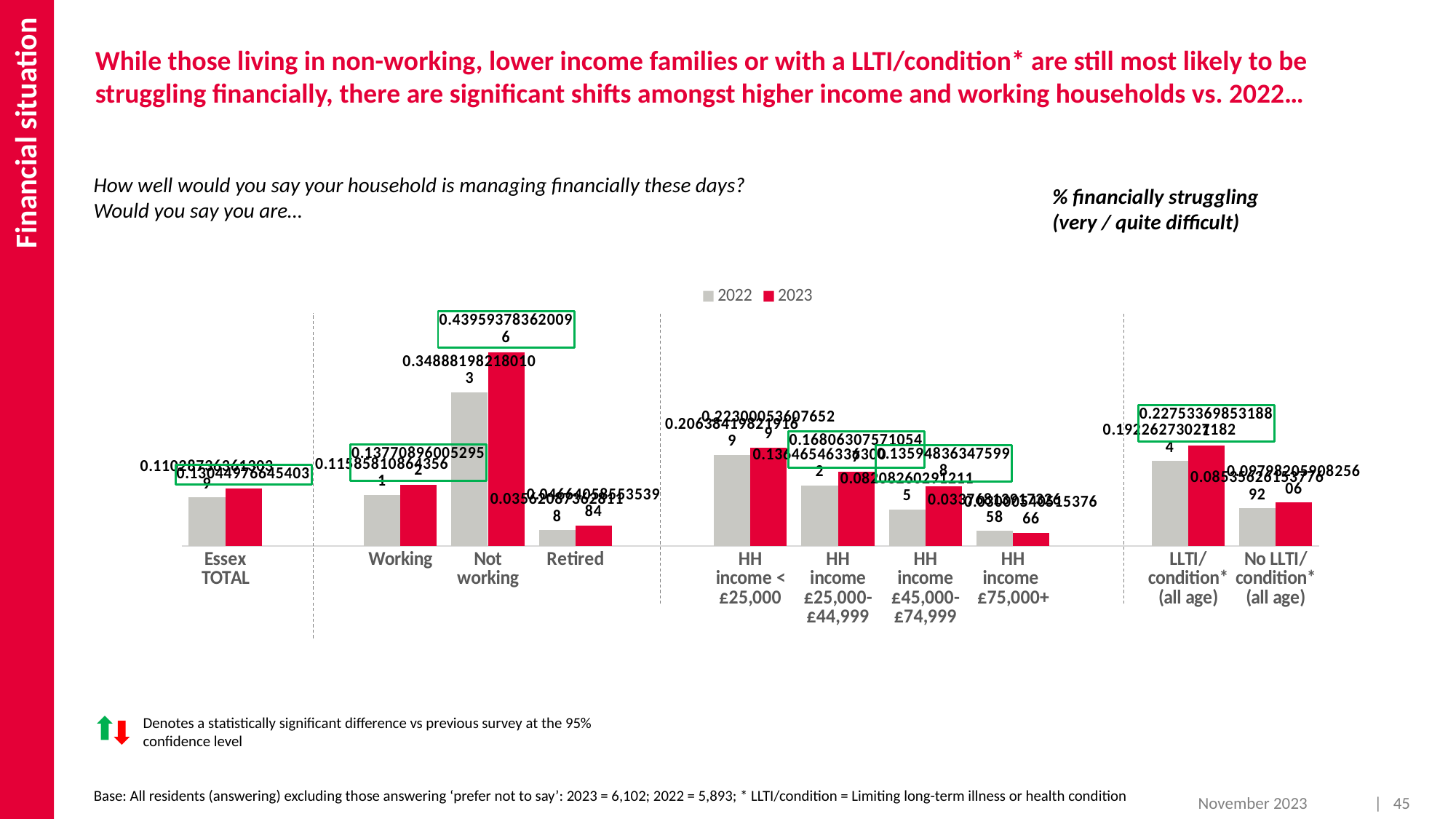
What is the 2023 value for the Not working category? 0.439593783620096 Which two years are listed in the chart legend? 2022 and 2023 Which category has the highest 2023 value? Not working Which colour represents the 2023 series in the chart? Red What is the 2023 value for Essex TOTAL? 0.130449976645403 What is the 2022 value for the Not working category? 0.348881982180103 How many series does the chart legend list? 2 Which category has the lowest 2023 value? HH income £75,000+ For the Not working category, is the 2022 or the 2023 value larger? 2023 What type of chart is shown on the slide? Bar chart For the Retired category, is the 2022 or the 2023 value larger? 2023 How many categories are shown along the x axis of the chart? 10